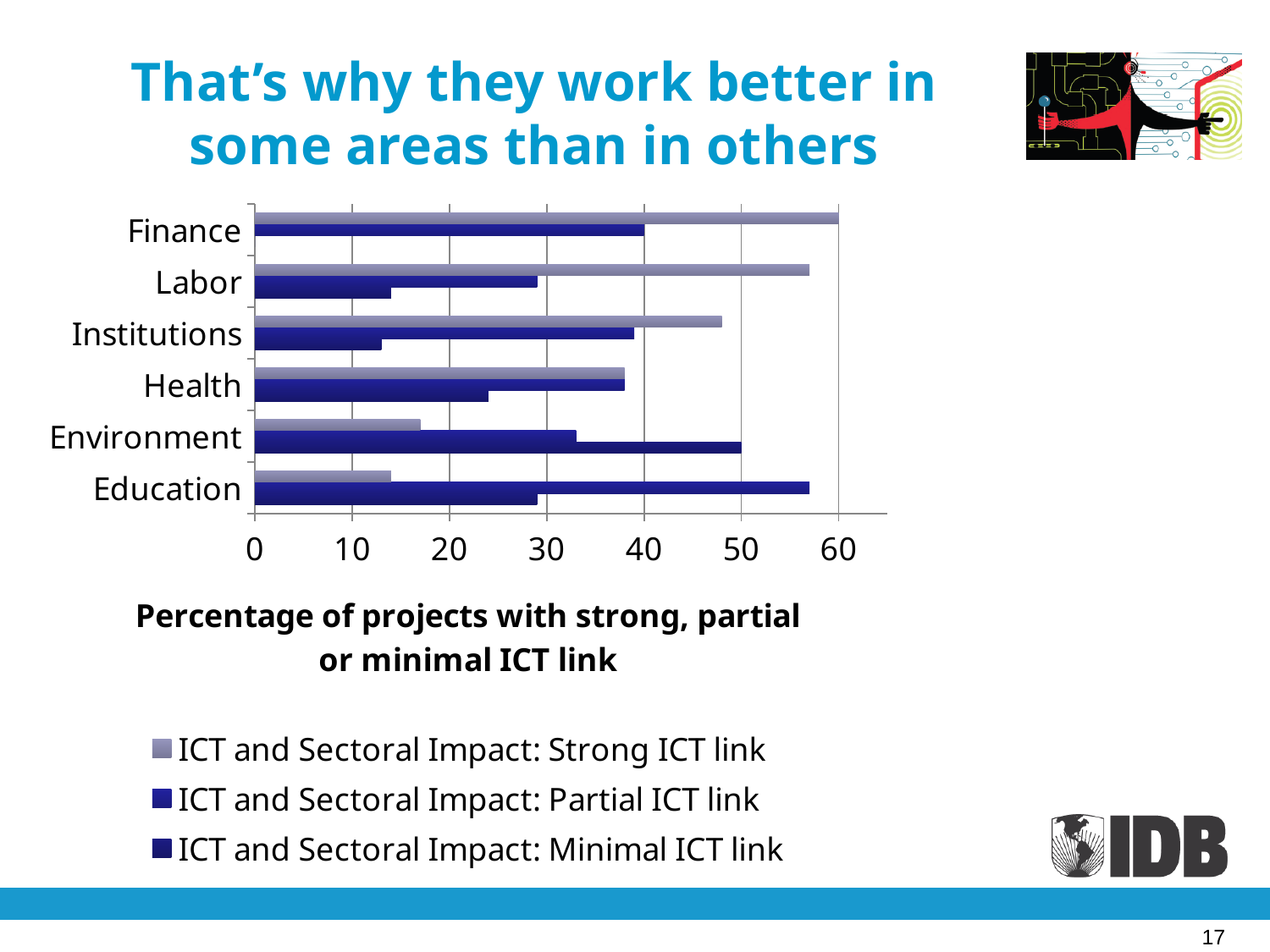
Is the Strong ICT link value for Labor greater or less than 50? greater What kind of chart is shown on the slide? bar chart How many categories (sectors) are shown on the chart? 6 Is the Strong ICT link value for Environment greater or less than 20? less What is the caption printed below the chart's axis? Percentage of projects with strong, partial or minimal ICT link For Education, which is larger: the Strong ICT link value or the Minimal ICT link value? Minimal ICT link Which sector has the highest value for the Minimal ICT link series? Environment How many series does the legend list? 3 Is the Partial ICT link value for Health greater or less than 30? greater Which is larger: the Strong ICT link value for Institutions or for Health? Institutions Which sector has the lowest value for the Partial ICT link series? Labor Which sector has the highest value for the Strong ICT link series? Finance